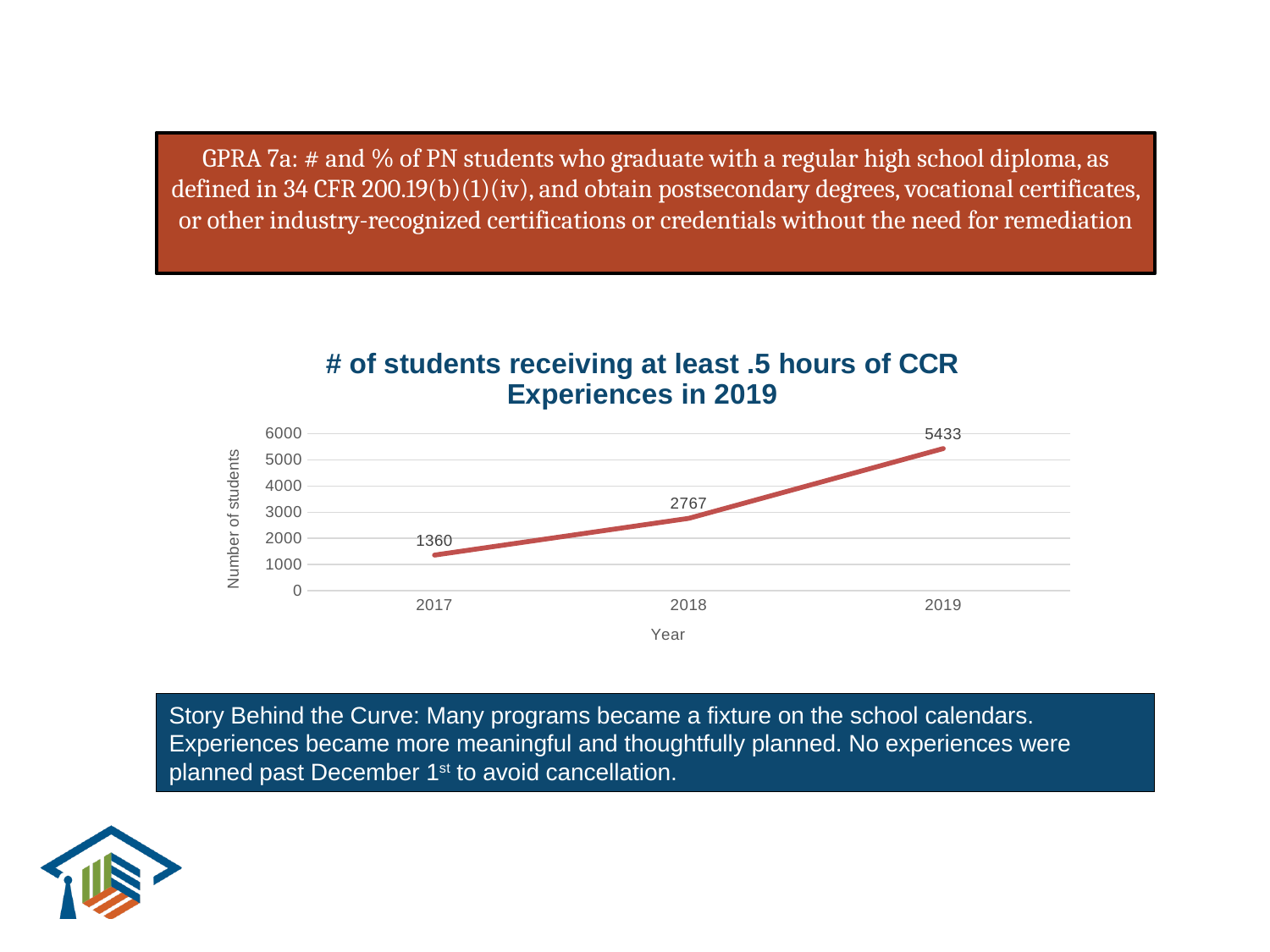
What is the number of students receiving at least .5 hours of CCR Experiences in 2019? 5433 Which year has the lowest number of students? 2017 What is the difference in the number of students between 2019 and 2018? 2666 How many years are plotted on the chart? 3 What is the difference in the number of students between 2018 and 2017? 1407 What is the number of students receiving at least .5 hours of CCR Experiences in 2018? 2767 Is the value for 2019 greater or less than 5000? greater Does the number of students rise or fall from 2017 to 2019? rise What is the number of students receiving at least .5 hours of CCR Experiences in 2017? 1360 Which year has more students, 2017 or 2018? 2018 Which year has the highest number of students? 2019 What kind of chart is shown on the slide? line chart